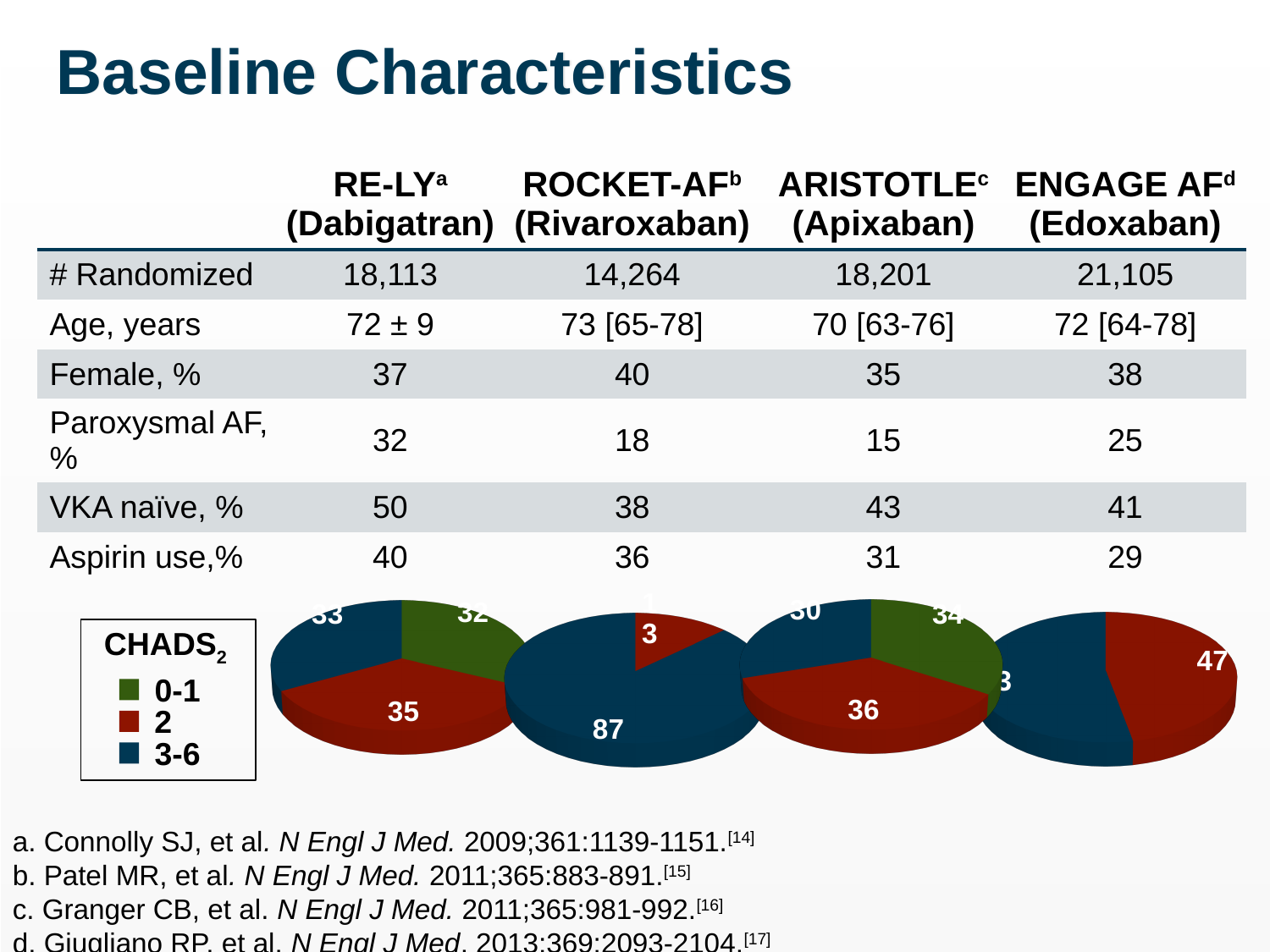
What kind of charts are shown at the bottom of the slide? Pie charts In the second pie chart from the left (under ROCKET-AF), which CHADS2 group has the largest slice? 3-6 In the second pie chart from the left (under ROCKET-AF), what value is shown for the CHADS2 3-6 slice? 87 In the rightmost pie chart (under ENGAGE AF), what value is shown for the CHADS2 2 slice? 47 In the leftmost pie chart (under RE-LY), what value is shown for the CHADS2 0-1 slice? 32 In the third pie chart from the left (under ARISTOTLE), what value is shown for the CHADS2 2 slice? 36 Which colour represents the CHADS2 3-6 group in the legend? Dark blue In the leftmost pie chart (under RE-LY), what percentage is shown for the CHADS2 2 slice? 35 In the third pie chart from the left (under ARISTOTLE), what value is shown for the CHADS2 0-1 slice? 34 In the third pie chart from the left (under ARISTOTLE), which CHADS2 group has the smallest slice? 3-6 How many entries does the CHADS2 legend list? 3 In the leftmost pie chart (under RE-LY), what is the difference between the CHADS2 2 slice and the CHADS2 0-1 slice? 3